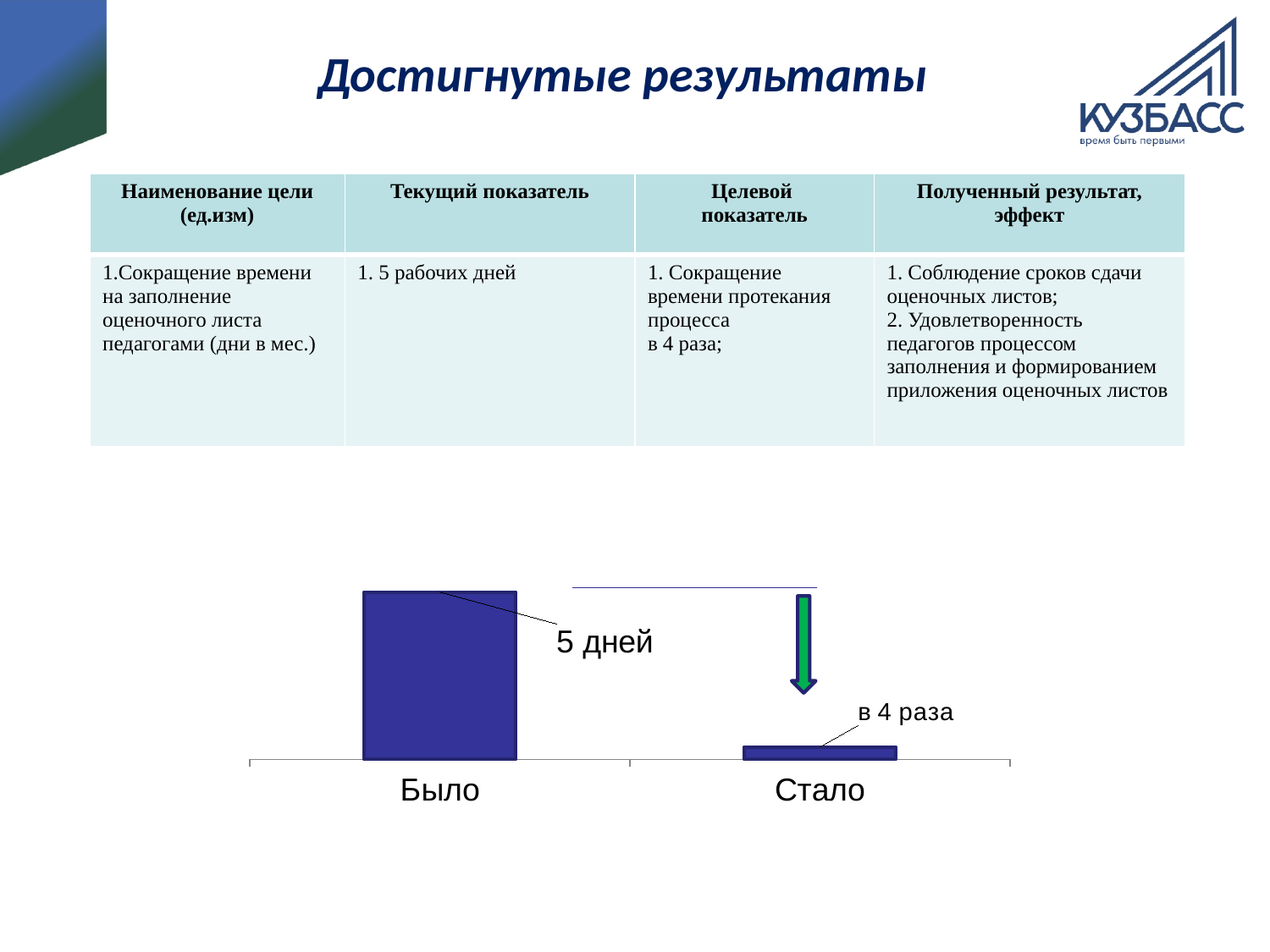
Do the bar values rise or fall from Было to Стало? fall What value is labelled on the bar for Было? 5 дней What are the category labels on the x axis of the bar chart? Было, Стало How many categories does the bar chart show? 2 What annotation is written next to the Стало bar? в 4 раза Which category has the lowest bar? Стало What kind of chart is shown at the bottom of the slide? bar chart Which bar is taller, Было or Стало? Было Which category has the highest bar? Было